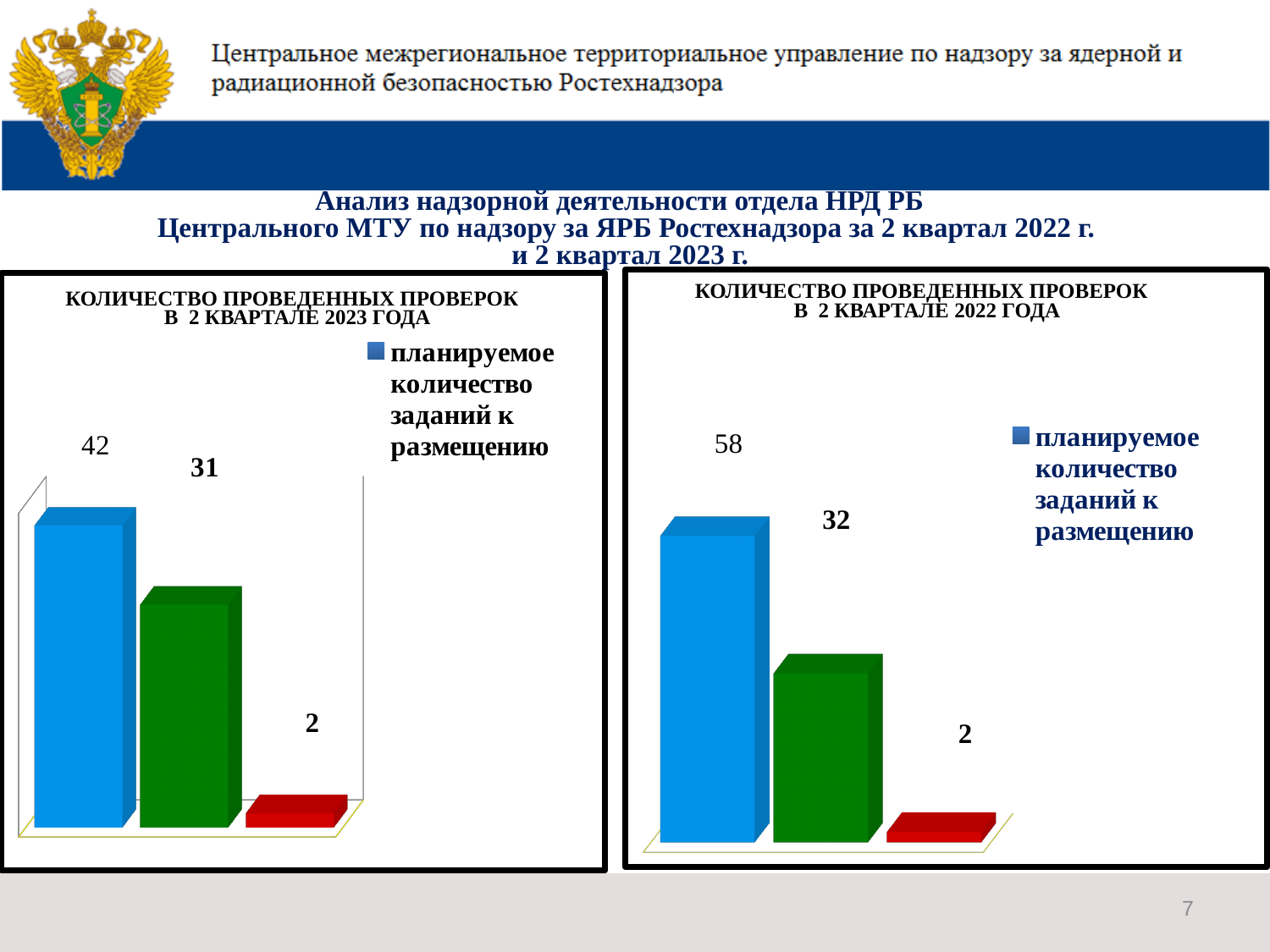
In the right chart (2 квартал 2022 года), do the bar values rise or fall from left to right? fall How many entries does the legend of the right chart (2 квартал 2022 года) list? 1 Which is larger: the 'планируемое количество заданий к размещению' value in the 2023 chart or in the 2022 chart? 2022 chart In the right chart (2 квартал 2022 года), what is the lowest value shown? 2 In the left chart (2 квартал 2023 года), what is the highest value shown? 42 In the chart titled 'КОЛИЧЕСТВО ПРОВЕДЕННЫХ ПРОВЕРОК В 2 КВАРТАЛЕ 2022 ГОДА', what is the value of the bar for 'планируемое количество заданий к размещению'? 58 In the chart titled 'КОЛИЧЕСТВО ПРОВЕДЕННЫХ ПРОВЕРОК В 2 КВАРТАЛЕ 2023 ГОДА', what is the value of the bar for 'планируемое количество заданий к размещению'? 42 What kind of chart is the left chart (2 квартал 2023 года)? bar chart In the right chart (2 квартал 2022 года), what is the difference between the highest and the lowest bar values? 56 How many bars are plotted in the left chart (2 квартал 2023 года)? 3 How many bars are plotted in the right chart (2 квартал 2022 года)? 3 In the left chart (2 квартал 2023 года), what is the difference between the highest and the lowest bar values? 40